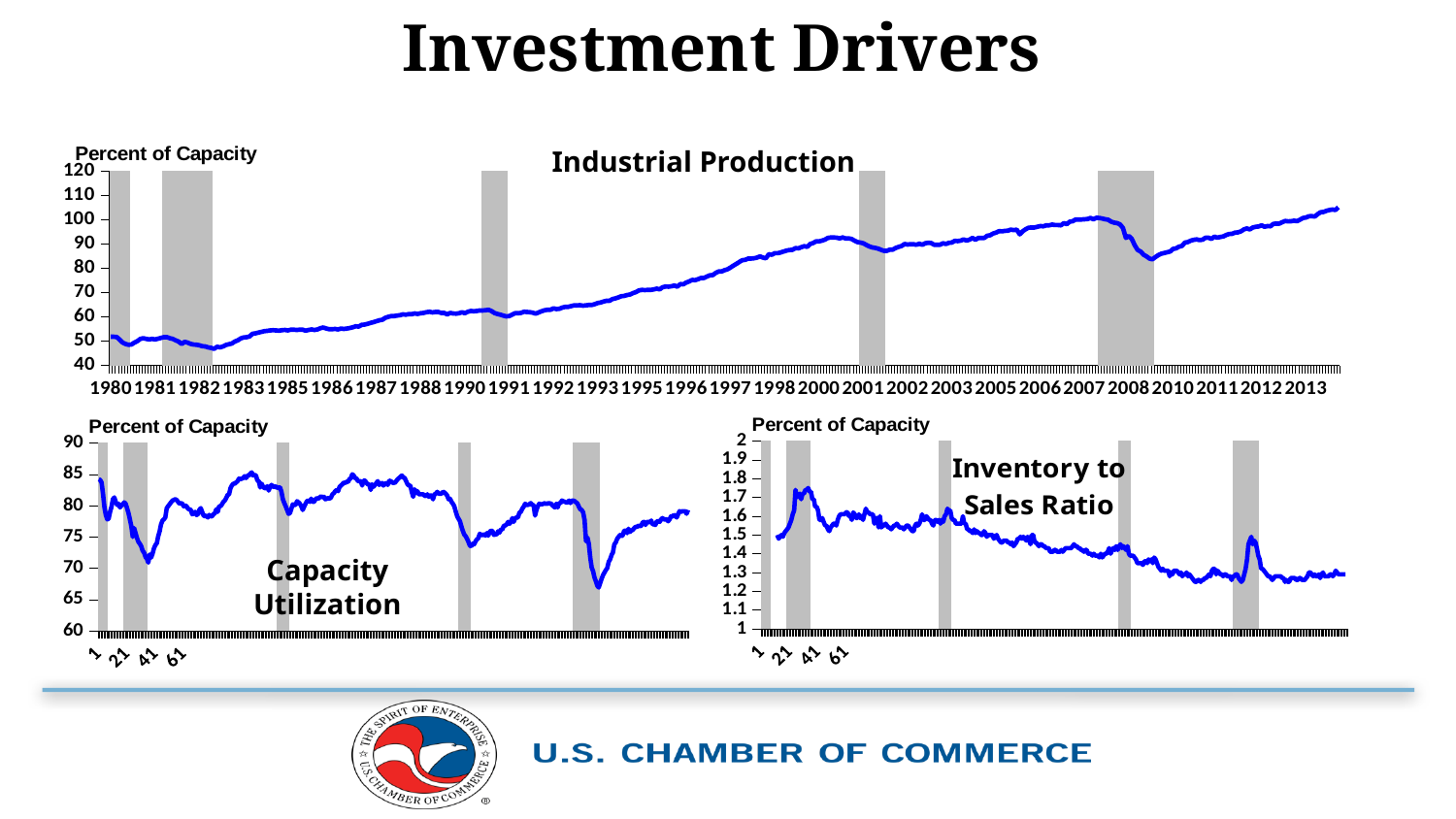
In the Industrial Production chart, is the value in 1980 greater or less than 60? less In the Inventory to Sales Ratio chart, does the line generally rise or fall from left to right? fall What is the y-axis label of the Industrial Production chart? Percent of Capacity In the Inventory to Sales Ratio chart, is the value at the end of the series greater or less than 1.5? less In the Industrial Production chart, which is larger, the value in 1980 or the value in 2013? 2013 In the Industrial Production chart, does the line generally rise or fall from 1980 to 2013? rise In the Capacity Utilization chart, is the lowest point of the line greater or less than 70? less What kind of chart is the Capacity Utilization chart? line chart What kind of chart is the Industrial Production chart? line chart